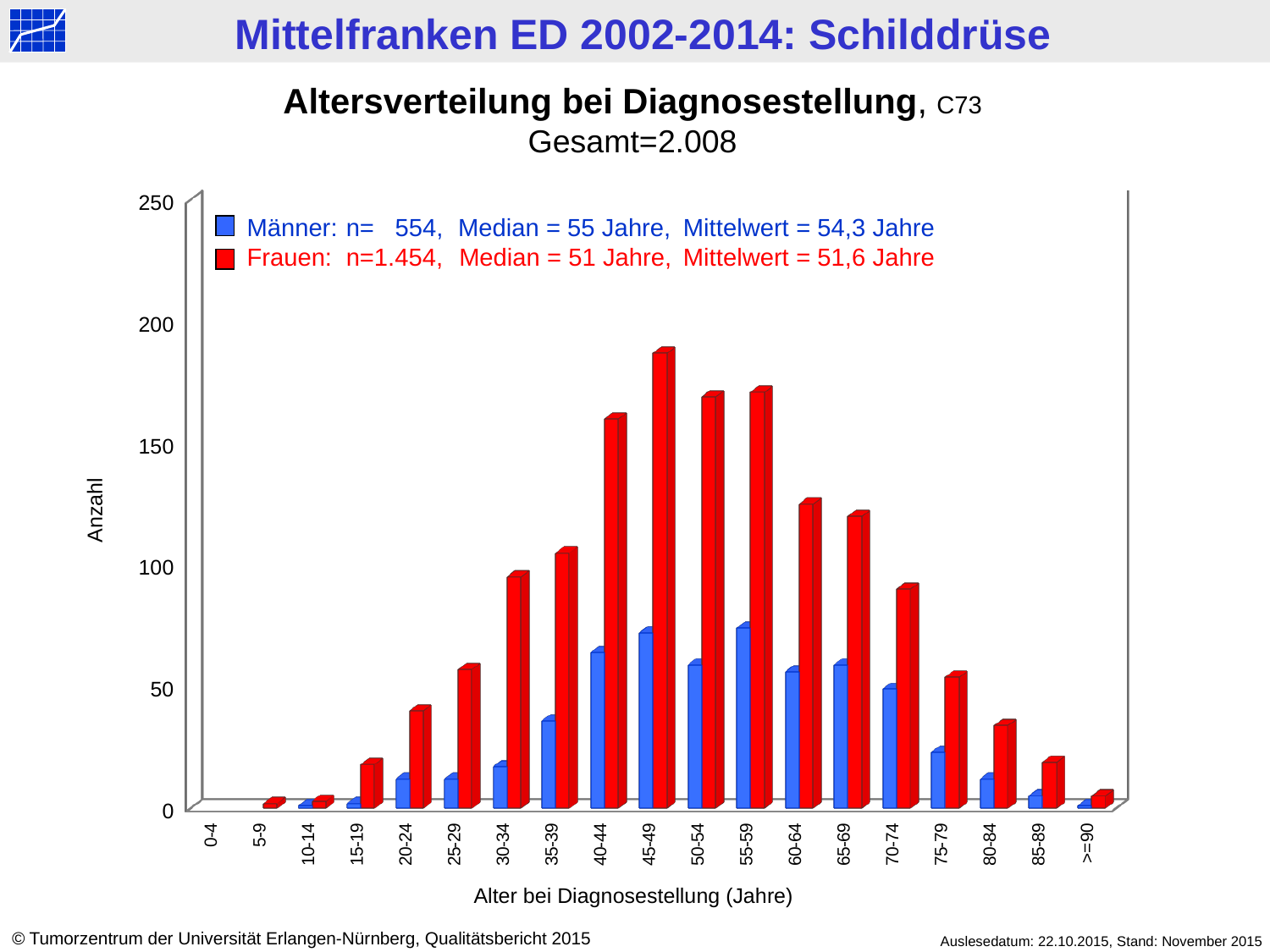
Is the value for Männer in the 75-79 age group greater or less than 50? less According to the legend, what is n for Frauen? 1.454 How many age groups are shown on the x axis? 19 Is the value for Männer in the 45-49 age group greater or less than 50? greater Is the value for Frauen in the 45-49 age group greater or less than 150? greater Which age group has the highest value for Frauen? 45-49 Do the values for Frauen rise or fall from the 45-49 age group to the 85-89 age group? fall In the 45-49 age group, which series has the larger value, Männer or Frauen? Frauen What kind of chart is shown on the slide? bar chart How many series does the legend list? 2